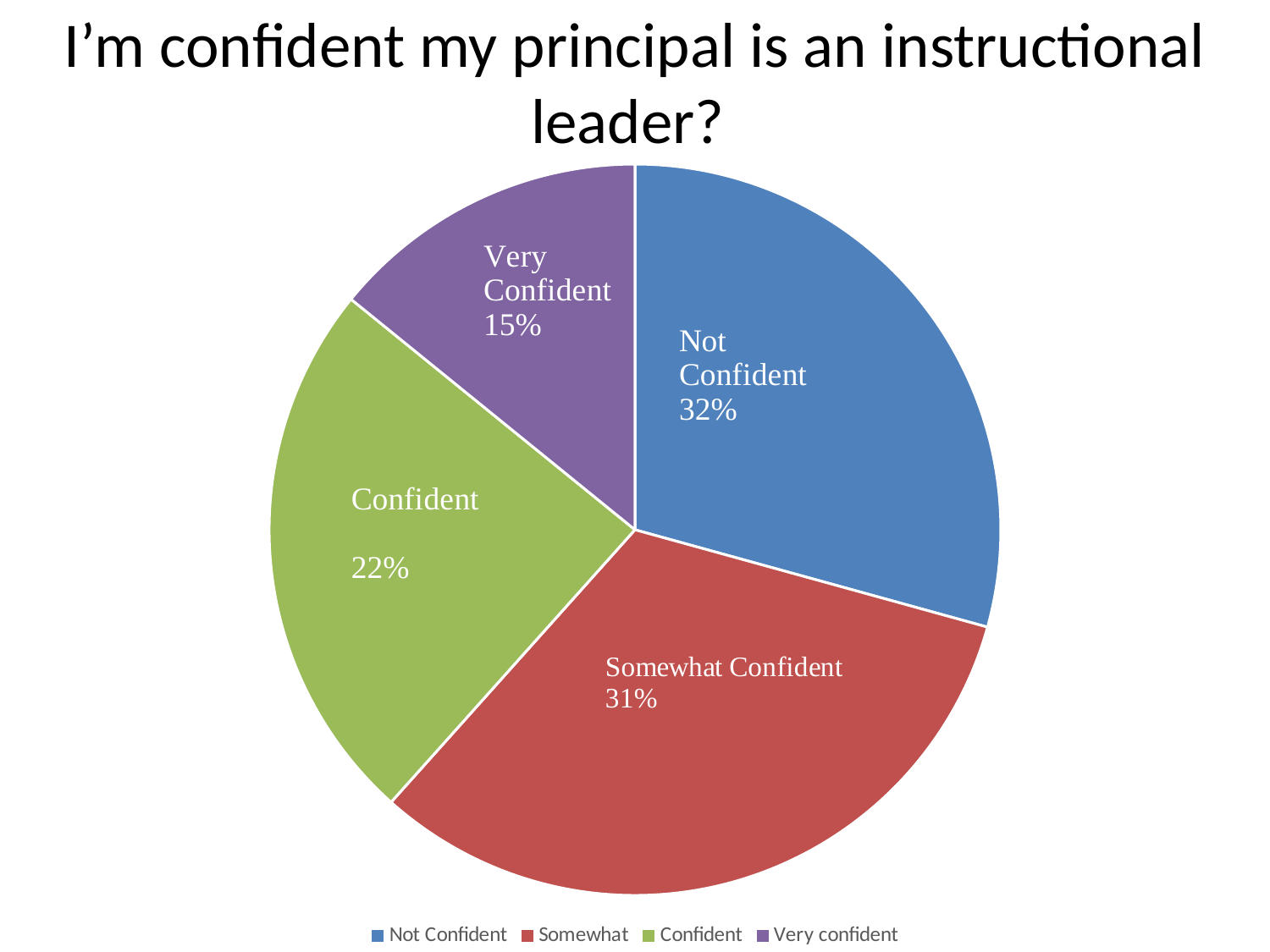
How many slices does the pie chart have? 4 What is the difference in percentage points between the Somewhat Confident and Confident slices? 9 What is the title of the chart? I'm confident my principal is an instructional leader? What kind of chart is shown on the slide? Pie chart What share of the pie is labelled Somewhat Confident? 31% What is the difference in percentage points between the Not Confident and Very Confident slices? 17 Which slice of the pie is the smallest? Very Confident What colour is the Somewhat Confident slice? Red What share of the pie is labelled Very Confident? 15% Which slice is larger, Confident or Very Confident? Confident What share of the pie is labelled Confident? 22% What share of the pie is labelled Not Confident? 32%